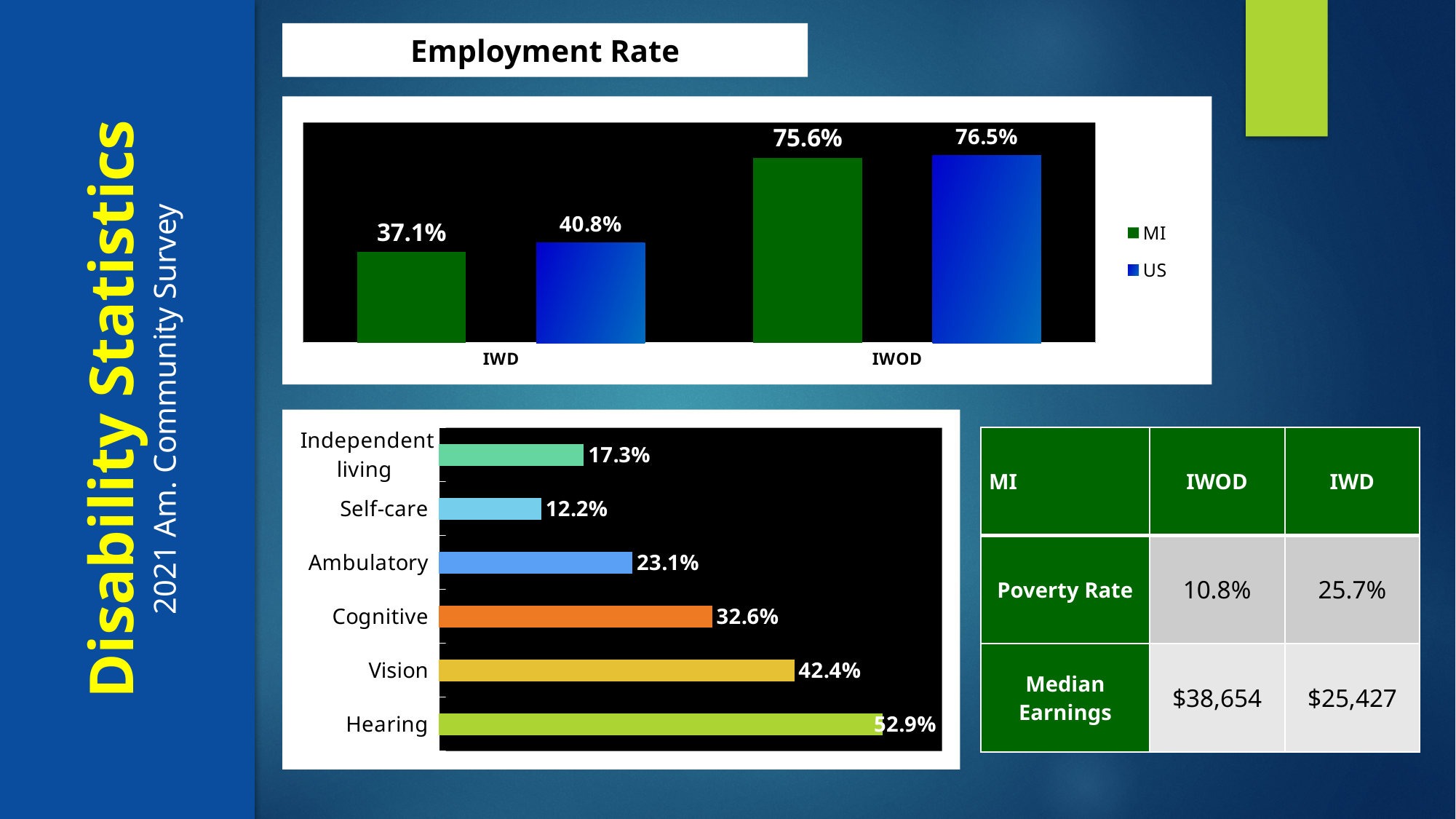
In the Employment Rate chart, what is the difference between the US and MI values for IWD? 3.7% In the lower-left horizontal bar chart, which category has the lowest value? Self-care In the lower-left horizontal bar chart, how many categories are shown? 6 In the lower-left horizontal bar chart, which category has the highest value? Hearing How many series does the legend of the Employment Rate chart list? 2 In the lower-left horizontal bar chart, what is the value for Cognitive? 32.6% In the Employment Rate chart, which is larger for IWOD, the MI value or the US value? US What type of chart is the Employment Rate chart? Bar chart In the Employment Rate chart, what is the employment rate for MI in the IWD category? 37.1% In the Employment Rate chart, which colour represents the US series? Blue In the Employment Rate chart, what is the employment rate for US in the IWOD category? 76.5% In the lower-left horizontal bar chart, what is the difference between the Vision and Ambulatory values? 19.3%